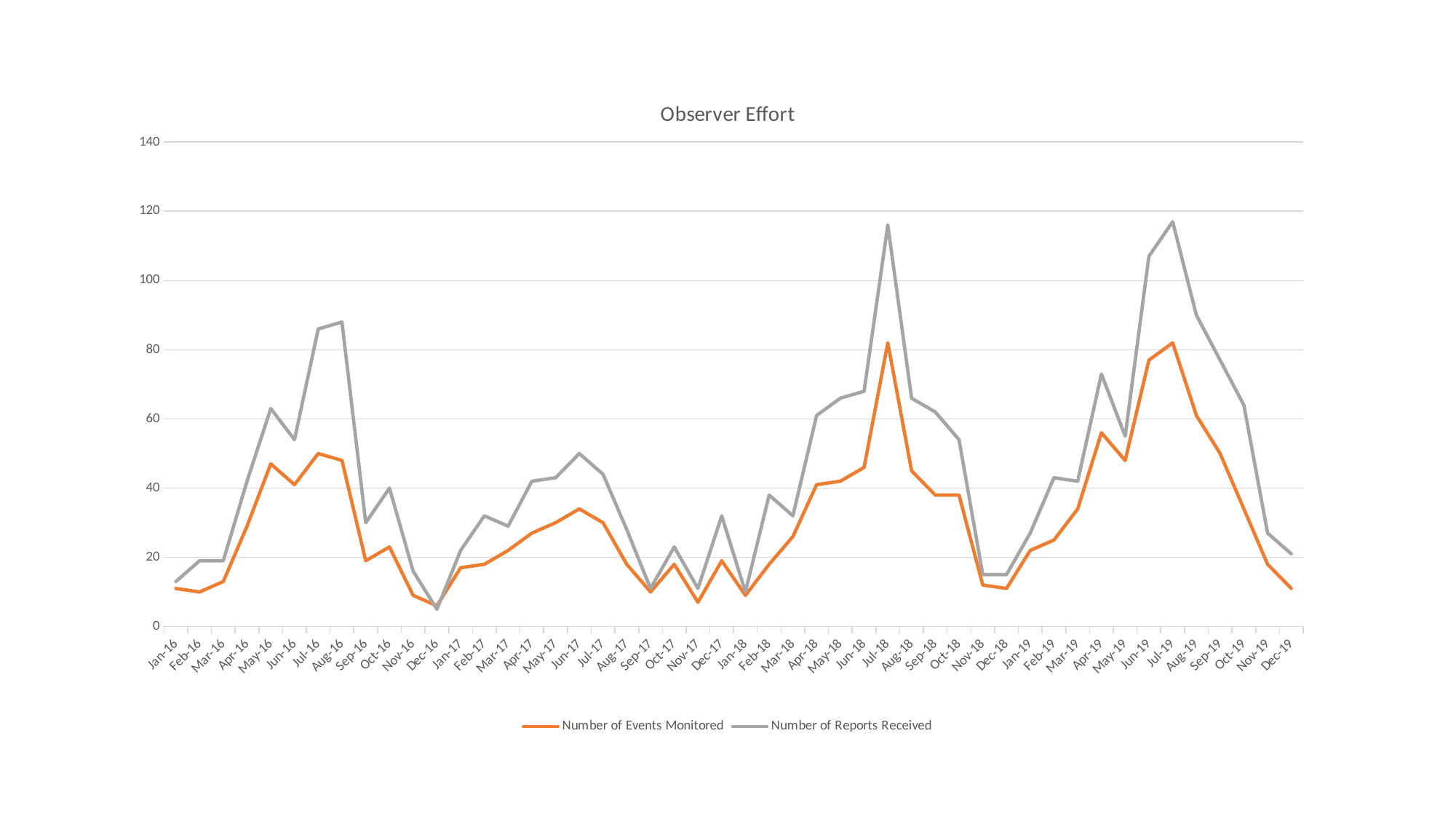
In Jul-18, which series has the larger value, Number of Events Monitored or Number of Reports Received? Number of Reports Received What is the title of the chart? Observer Effort Is the value for Number of Reports Received in Jun-17 greater or less than 60? less In which month is Number of Reports Received lowest? Dec-16 How many series does the legend list? 2 What kind of chart is shown on the slide? line chart How many months are shown along the x axis? 48 Which colour is the Number of Events Monitored line? orange Is the value for Number of Events Monitored in Dec-16 greater or less than 20? less Is the value for Number of Reports Received in Jul-18 greater or less than 100? greater Does Number of Reports Received rise or fall from Jul-19 to Dec-19? fall